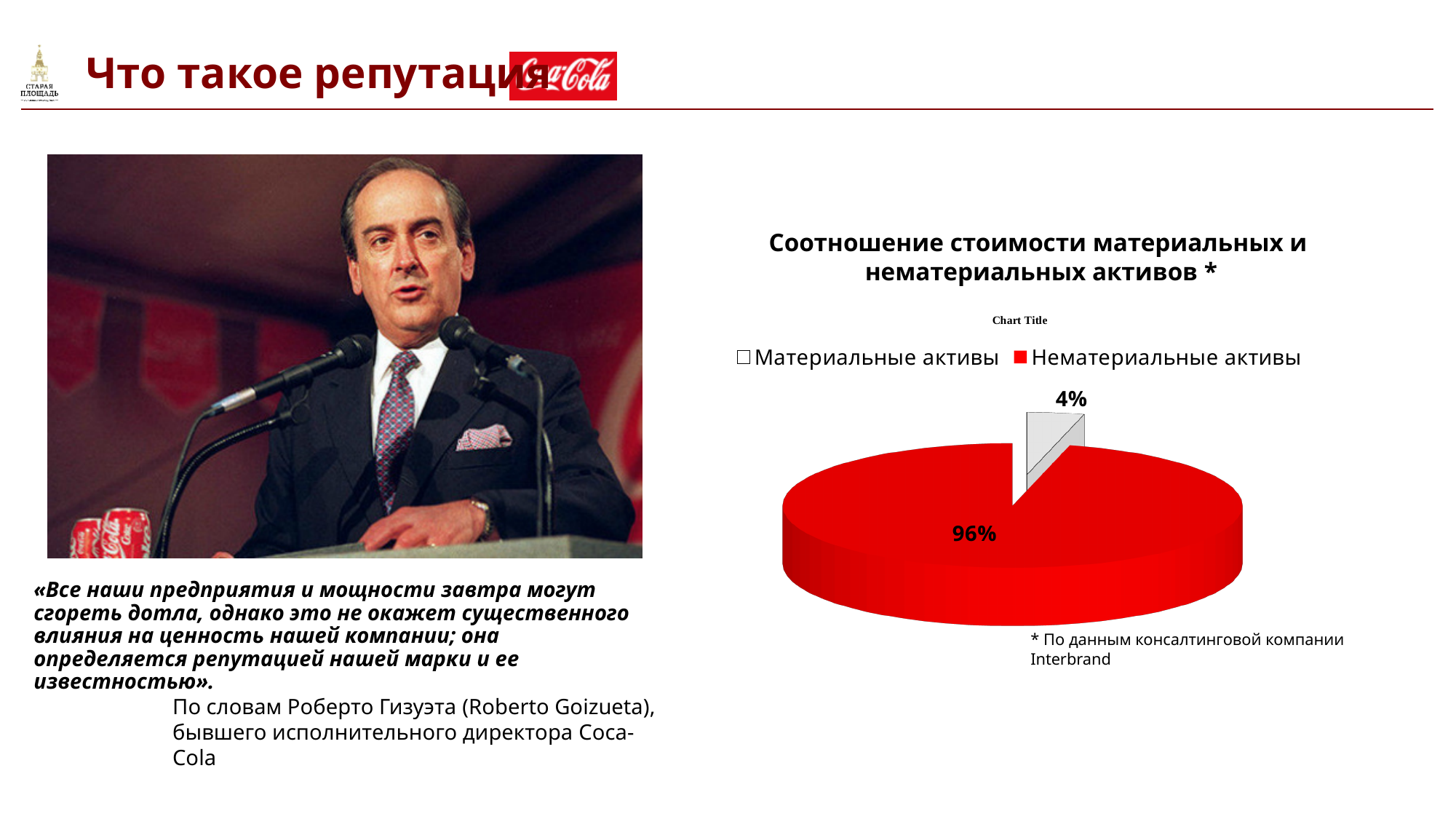
What colour is the Нематериальные активы slice in the pie chart? Red How many slices does the pie chart have? 2 Which category has the smallest slice in the pie chart? Материальные активы How many entries does the chart legend list? 2 What share of the pie chart is labelled for Нематериальные активы? 96% What is the heading above the pie chart? Соотношение стоимости материальных и нематериальных активов * Which is larger in the pie chart: Материальные активы or Нематериальные активы? Нематериальные активы Which category has the largest slice in the pie chart? Нематериальные активы What share of the pie chart is labelled for Материальные активы? 4% What is the difference in percentage points between the Нематериальные активы and Материальные активы slices? 92 What kind of chart is shown on the slide? Pie chart